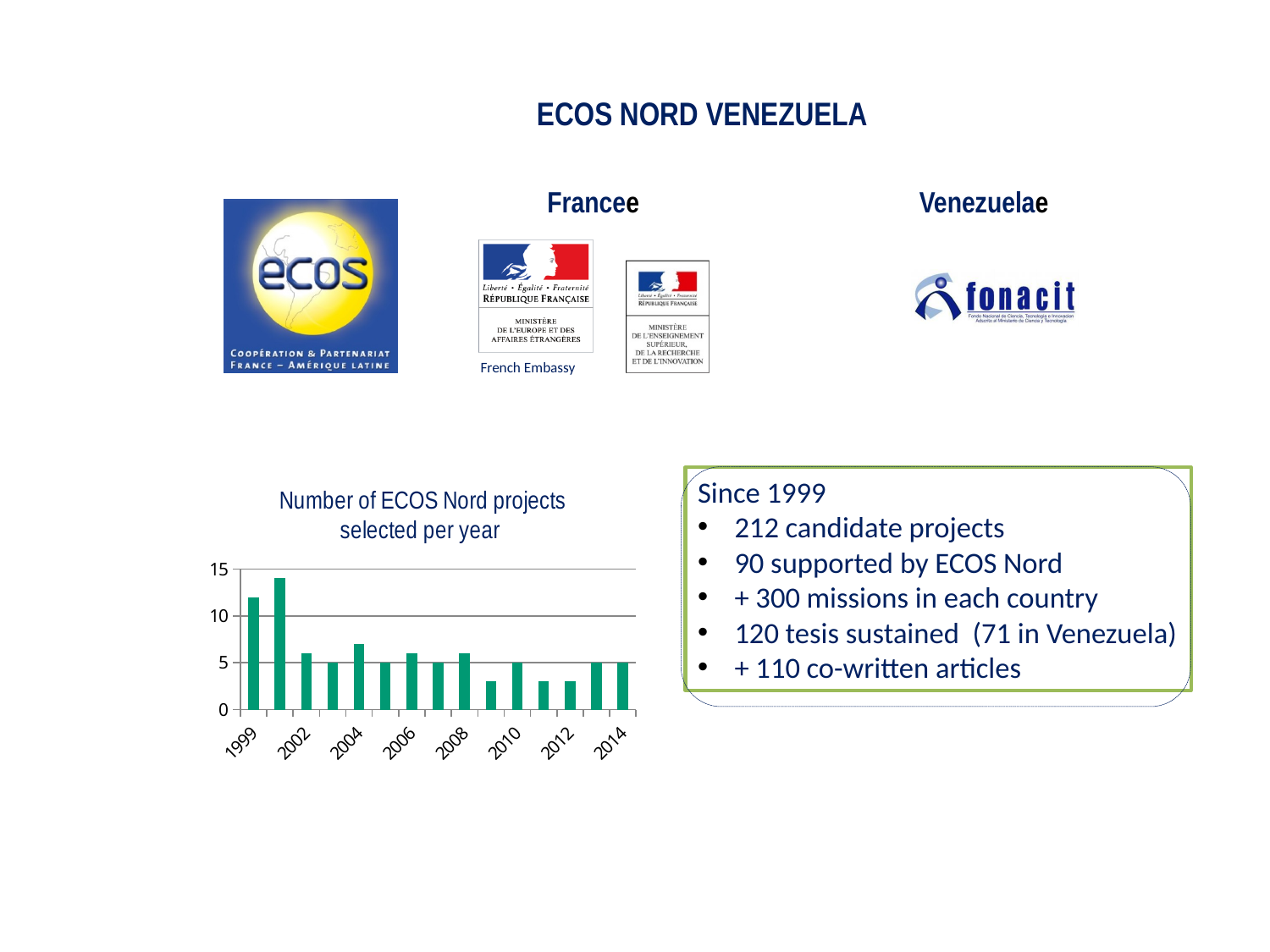
What kind of chart is shown on the slide? bar chart Is the value for 1999 greater or less than 10? greater Is the value for 2008 greater or less than 10? less What is the title of the chart on the slide? Number of ECOS Nord projects selected per year Is the value for 2014 greater or less than 10? less Which year has the larger value, 1999 or 2008? 1999 Do the values generally rise or fall from 1999 to 2014? fall What is the highest value shown on the vertical axis of the chart? 15 Which year has the larger value, 1999 or 2014? 1999